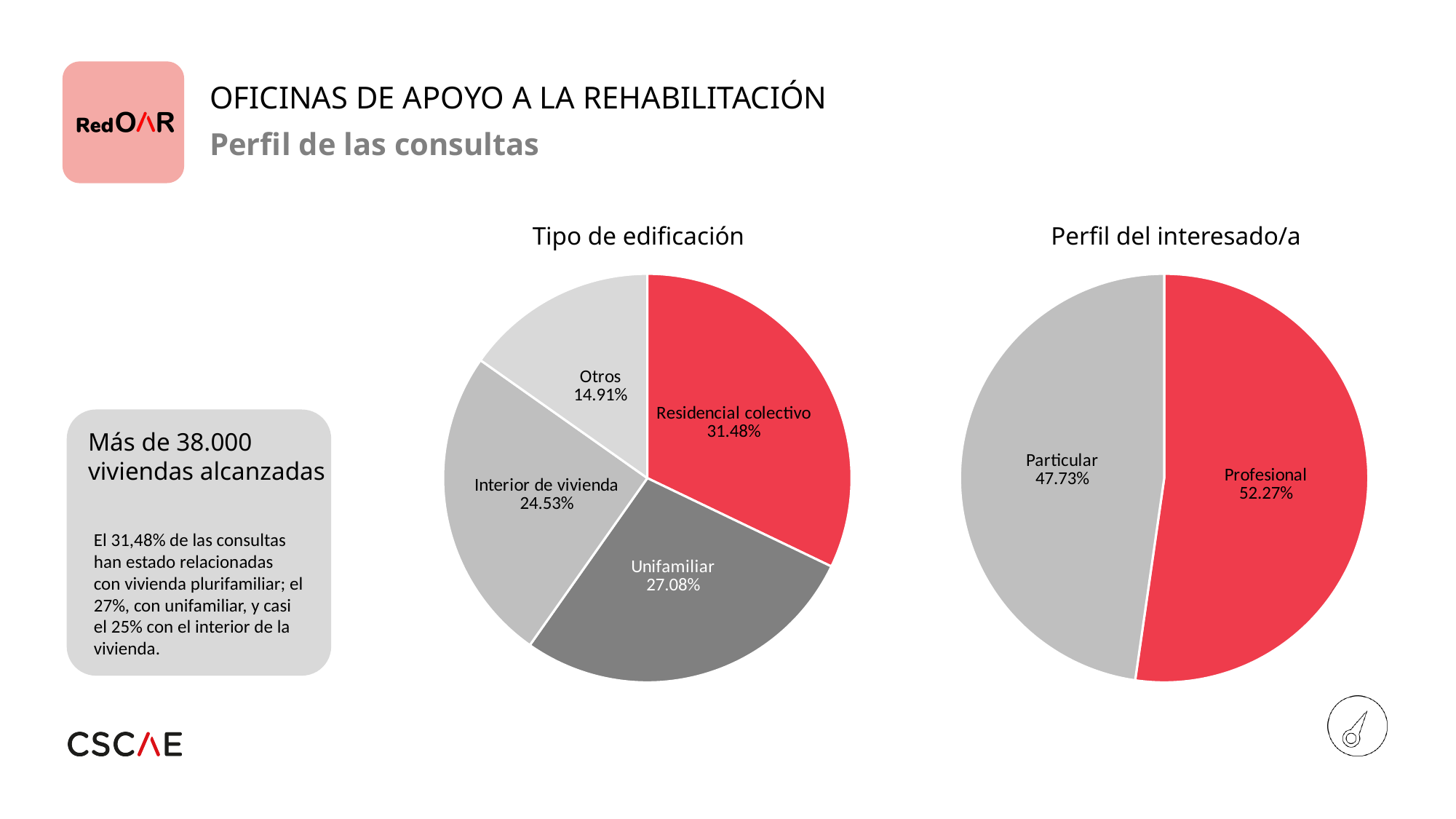
In the 'Tipo de edificación' chart, what is the share for Residencial colectivo? 31.48% In the 'Tipo de edificación' chart, what is the difference in percentage points between Unifamiliar and Otros? 12.17 In the 'Perfil del interesado/a' chart, which category has the larger share? Profesional In the 'Tipo de edificación' chart, how many slices does the pie have? 4 What kind of chart is the 'Perfil del interesado/a' chart? Pie chart In the 'Tipo de edificación' chart, what colour is the Residencial colectivo slice? Red In the 'Perfil del interesado/a' chart, what is the difference in percentage points between Profesional and Particular? 4.54 In the 'Tipo de edificación' chart, what is the share for Interior de vivienda? 24.53% In the 'Perfil del interesado/a' chart, what is the share for Particular? 47.73% In the 'Tipo de edificación' chart, which category has the smallest share? Otros In the 'Tipo de edificación' chart, which is larger, Unifamiliar or Interior de vivienda? Unifamiliar In the 'Tipo de edificación' chart, which category has the largest share? Residencial colectivo